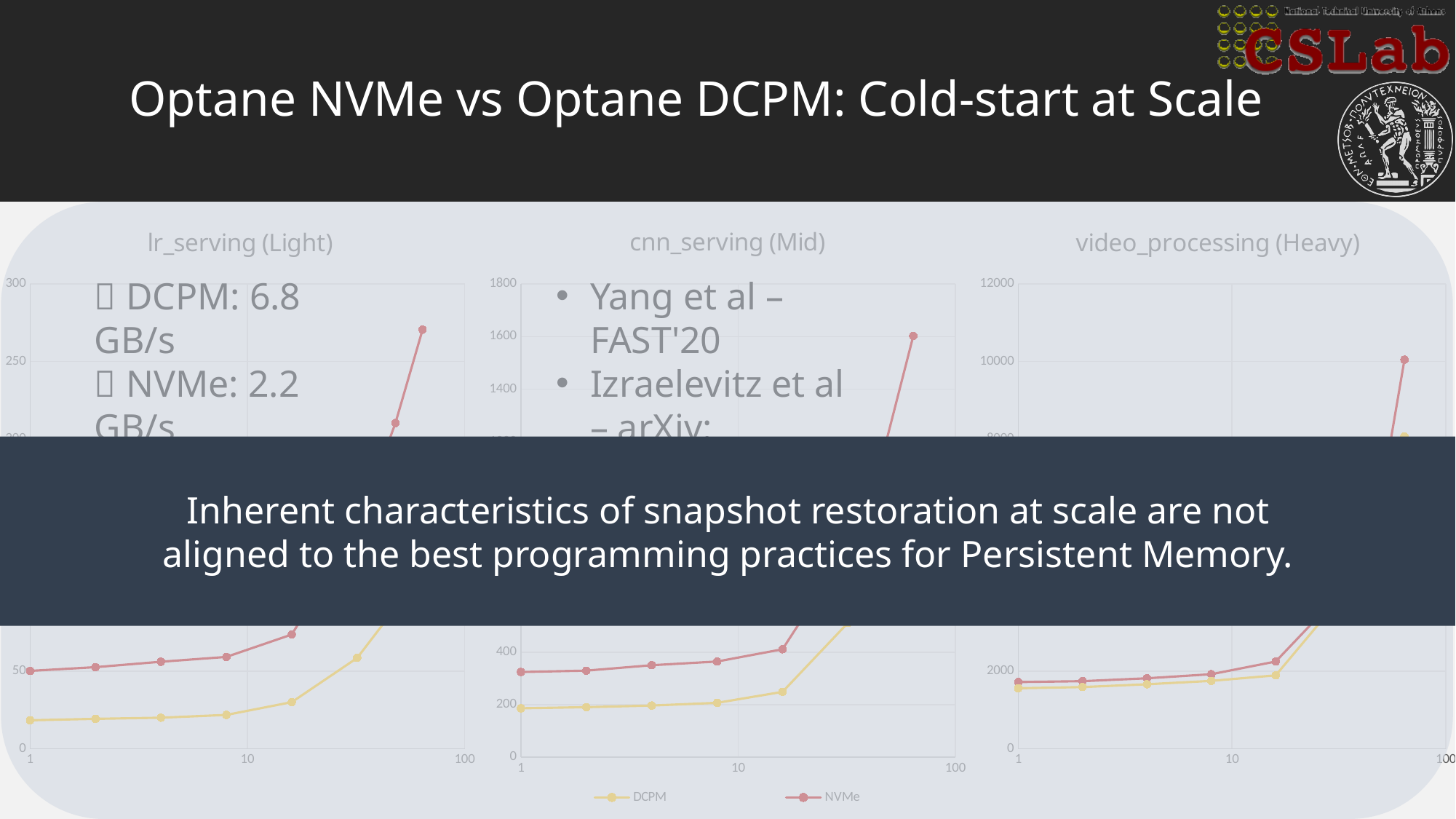
In the video_processing (Heavy) chart, is the DCPM value at x = 1 greater or less than 2000? less In the cnn_serving (Mid) chart, is the NVMe value at x = 1 greater or less than 200? greater What is the title of the rightmost chart? video_processing (Heavy) How many series does the legend at the bottom of the slide list? 2 In the lr_serving (Light) chart, do the NVMe values rise or fall as x increases? rise In the lr_serving (Light) chart, is the highest NVMe value greater or less than 250? greater In the video_processing (Heavy) chart, which series has the larger value at x = 1, DCPM or NVMe? NVMe In the cnn_serving (Mid) chart, which series has the larger value at x = 1, DCPM or NVMe? NVMe What kind of chart is the lr_serving (Light) chart? line chart What are the two series named in the legend? DCPM and NVMe